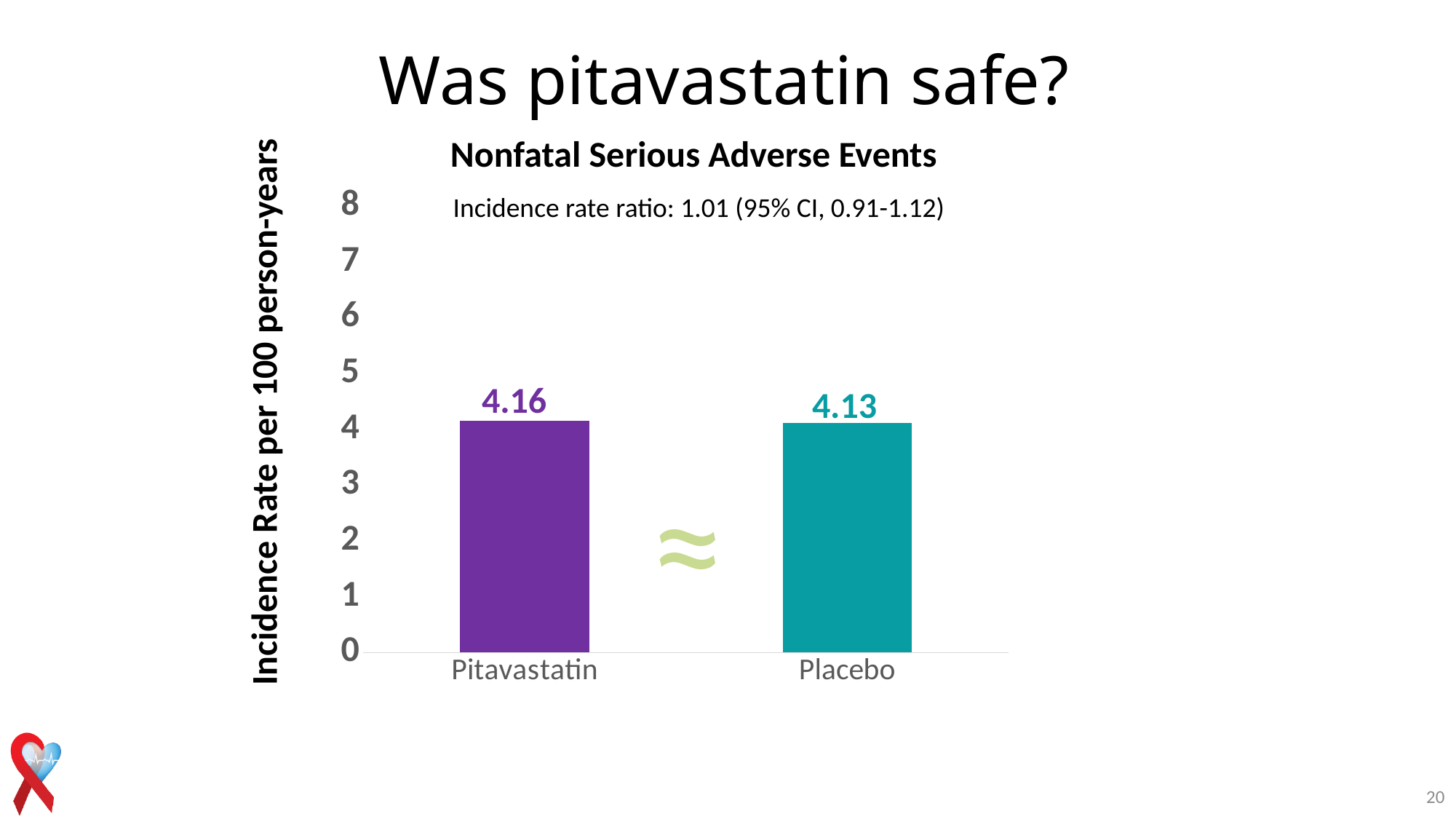
What incidence rate ratio is printed on the chart? 1.01 (95% CI, 0.91-1.12) How many categories are shown on the x axis? 2 Is the value for Placebo greater or less than 3? greater What is the label of the y axis? Incidence Rate per 100 person-years What kind of chart is shown on the slide? Bar chart What is the incidence rate per 100 person-years for Pitavastatin? 4.16 Is the value for Pitavastatin greater or less than 5? less What is the title of the chart? Nonfatal Serious Adverse Events What is the incidence rate per 100 person-years for Placebo? 4.13 What is the maximum value shown on the y axis? 8 What is the difference between the Pitavastatin and Placebo incidence rates? 0.03